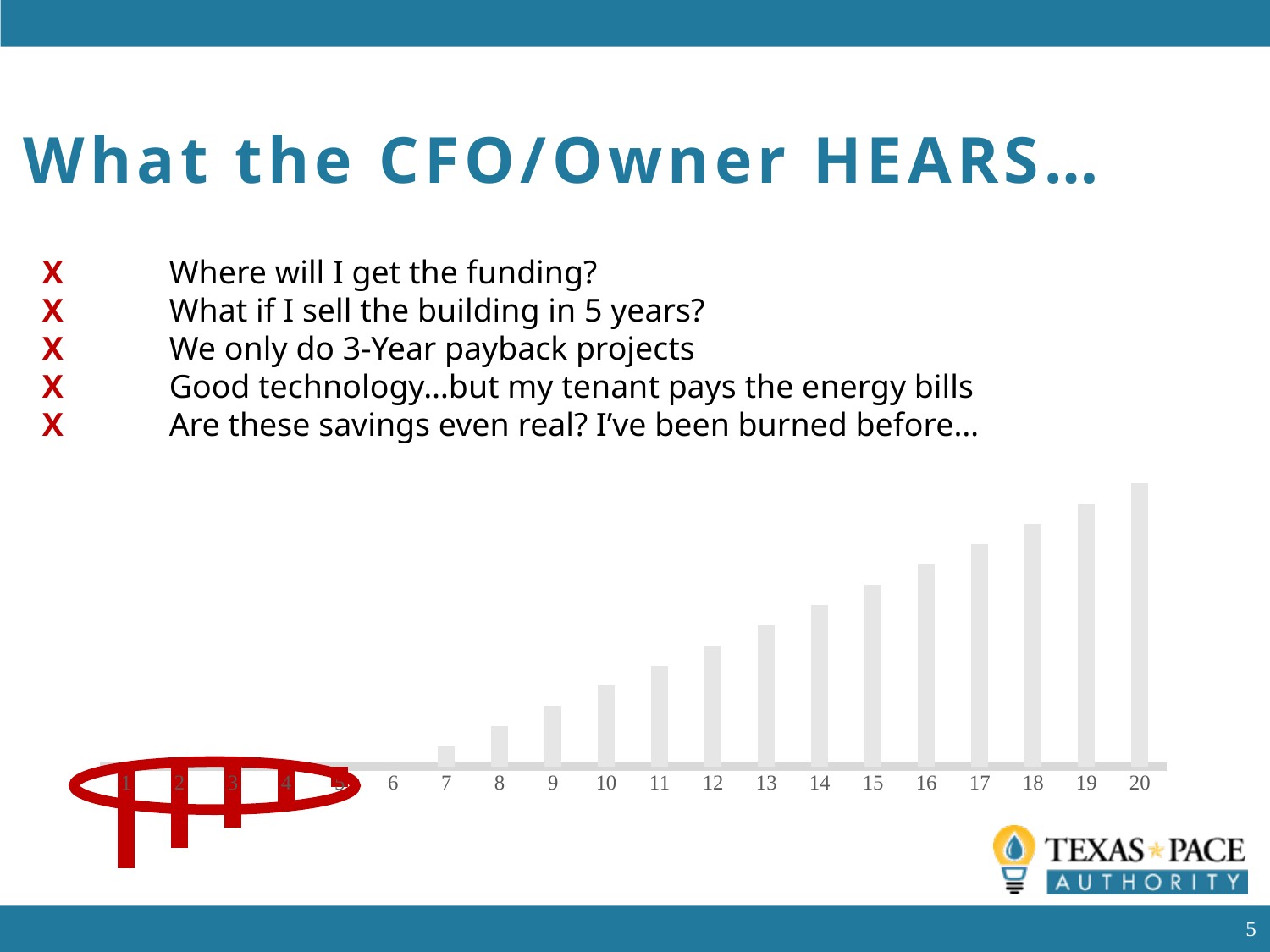
How many categories are labelled on the x axis of the bar chart? 20 Do the bar heights rise or fall as the x axis goes from 7 to 20? Rise Which category has the tallest bar in the chart? 20 Which bar is taller, the one for category 15 or the one for category 10? 15 What kind of chart is shown at the bottom of the slide? Bar chart Which bar is taller, the one for category 8 or the one for category 18? 18 What is the first x-axis category label on the chart? 1 What is the last x-axis category label on the chart? 20 Which bar is shorter, the one for category 7 or the one for category 12? 7